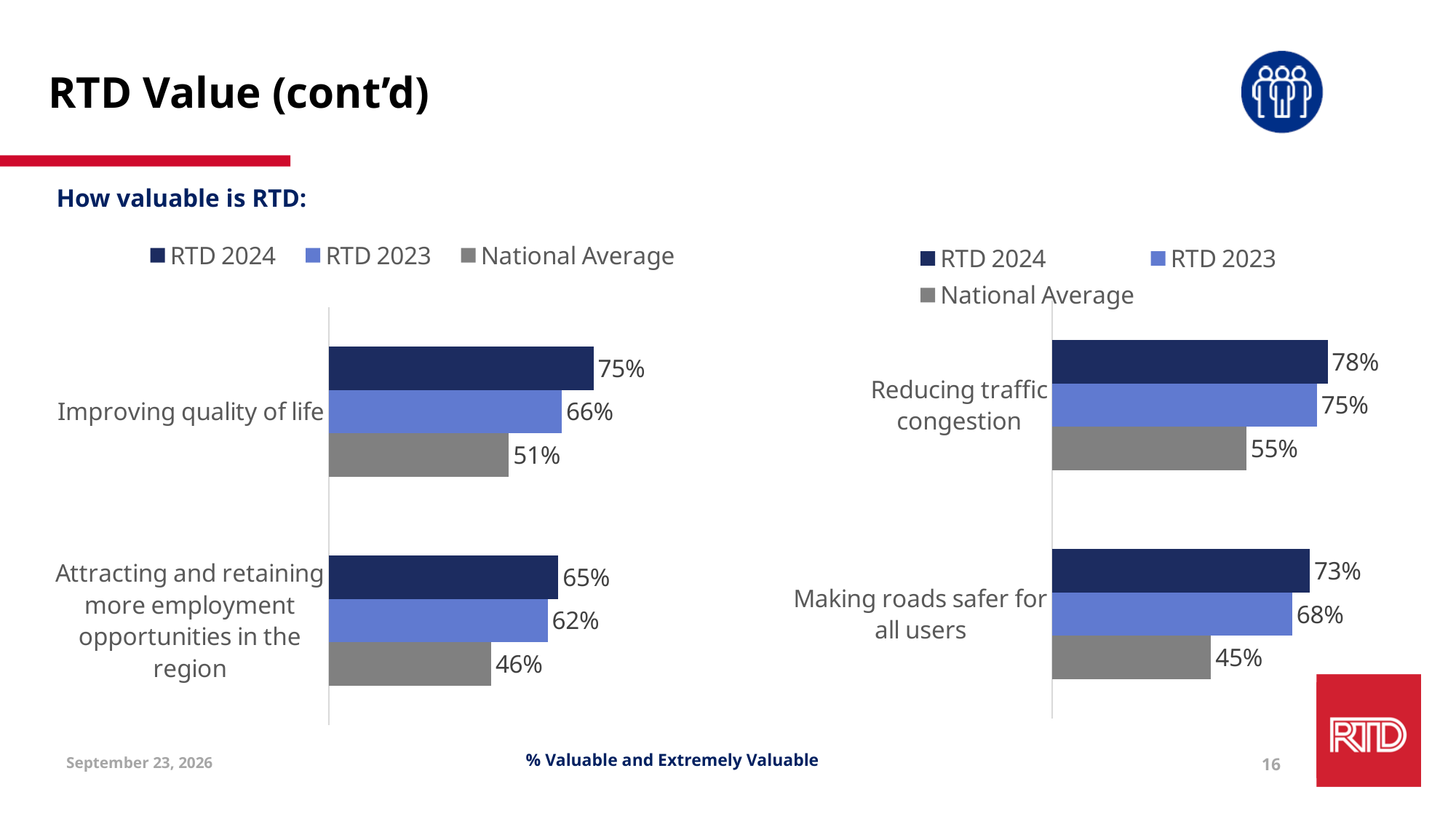
In the left chart, which series has the lowest value for Improving quality of life? National Average In the left chart, what is the difference between the RTD 2024 and National Average values for Improving quality of life? 24% In the left chart, what is the RTD 2024 value for Improving quality of life? 75% How many categories are shown in the left chart? 2 In the left chart, what is the National Average value for Attracting and retaining more employment opportunities in the region? 46% What kind of chart is the right chart? Bar chart How many series does the legend of the right chart list? 3 In the right chart, what is the difference between the RTD 2024 and RTD 2023 values for Making roads safer for all users? 5% In the right chart, what is the RTD 2023 value for Reducing traffic congestion? 75% In the left chart, which is larger: the RTD 2023 value for Improving quality of life or the RTD 2023 value for Attracting and retaining more employment opportunities in the region? Improving quality of life In the right chart, which series has the highest value for Reducing traffic congestion? RTD 2024 In the right chart, what is the National Average value for Making roads safer for all users? 45%